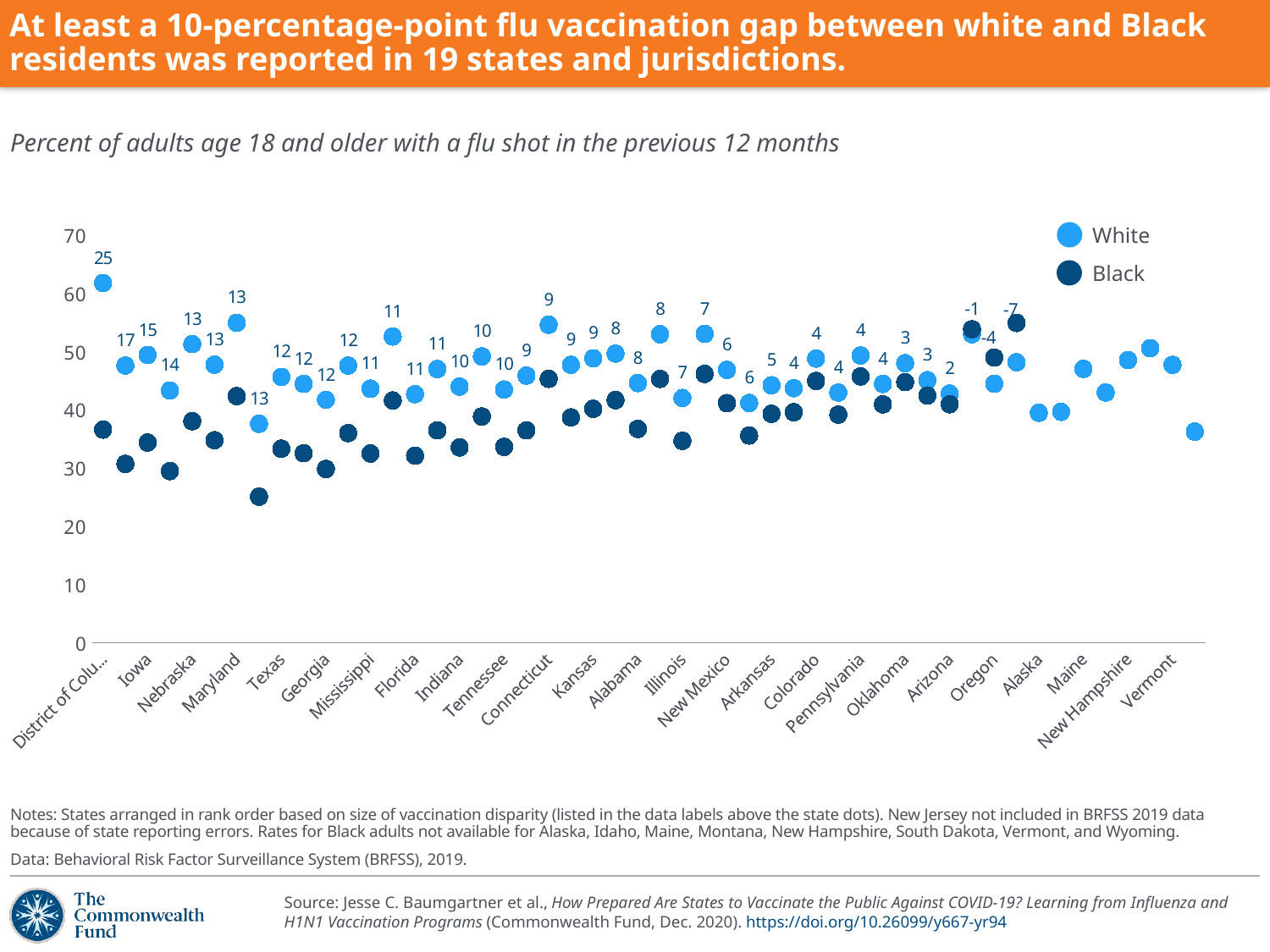
Is the Black value for Texas greater or less than 40? less Is the Black value for District of Columbia greater or less than 40? less What is the smallest (most negative) gap data label shown on the chart? -7 What are the two series named in the legend? White and Black How many series does the legend list? 2 For District of Columbia, which is higher, the White value or the Black value? White What is the vaccination gap data label shown for District of Columbia? 25 What kind of chart is shown on the slide? Dot (scatter) chart Do the gap data labels rise or fall moving from left to right along the x axis? fall Is the White value for District of Columbia greater or less than 60? greater What is the vaccination gap data label shown for Iowa? 15 Which state or jurisdiction has the largest vaccination gap data label? District of Columbia